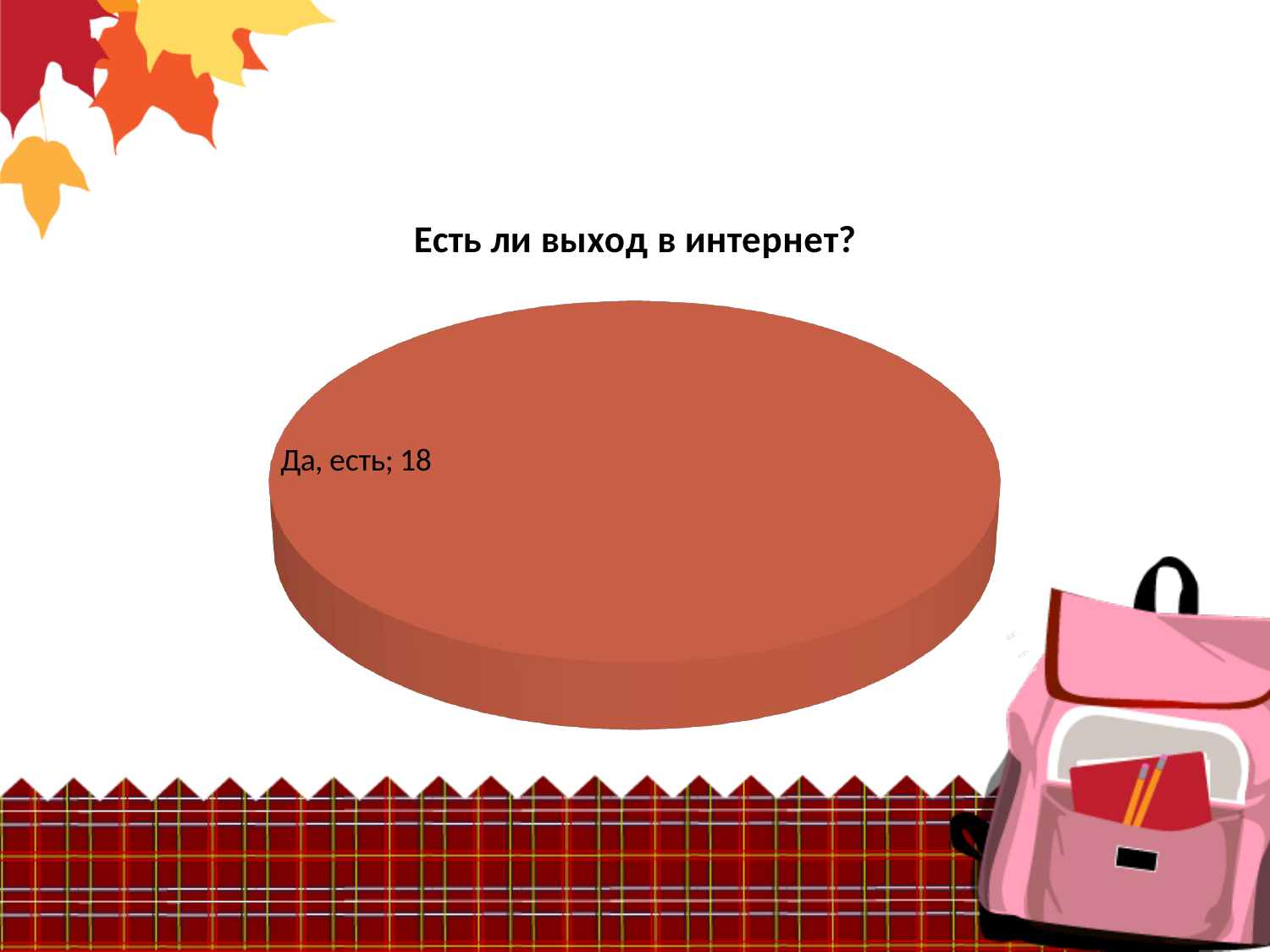
What is the value shown for the category "Да, есть"? 18 Which category has the highest value in the chart? Да, есть Is the value for "Да, есть" greater or less than 10? greater What kind of chart is shown on the slide? pie chart What colour is the slice labelled "Да, есть"? reddish-brown (terracotta) What is the title of the chart? Есть ли выход в интернет? How many categories (slices) does the pie chart show? 1 What share of the pie does the slice "Да, есть" take up? 100%